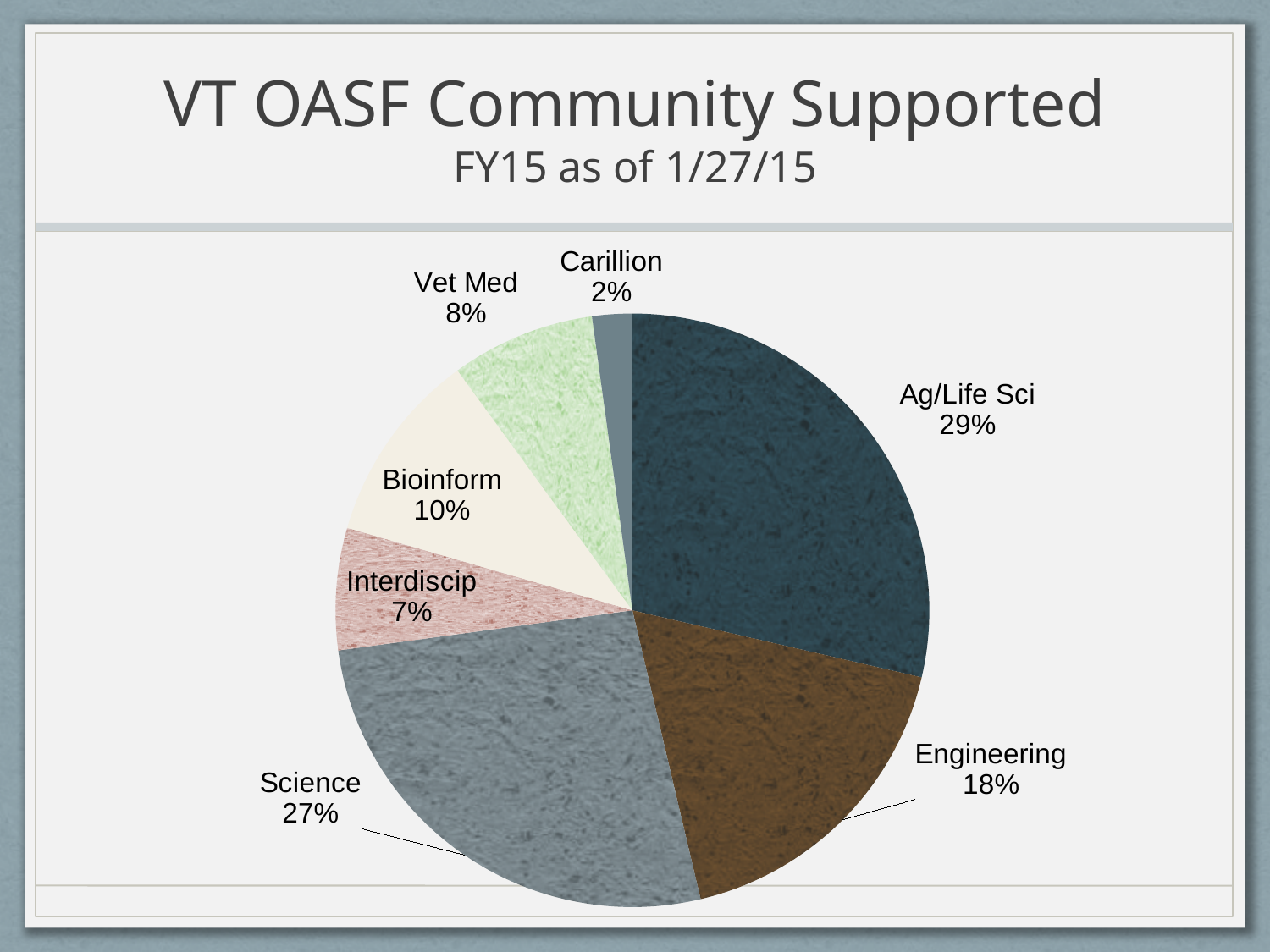
Which category has the smallest slice of the pie? Carillion What is the difference in percentage points between Science and Engineering? 9 How many categories are shown in the pie chart? 7 What percentage is shown for Bioinform? 10% What is the combined percentage of Ag/Life Sci and Science? 56% What percentage is shown for Engineering? 18% Which is larger, Vet Med or Interdiscip? Vet Med What percentage is shown for Carillion? 2% Which category has the largest slice of the pie? Ag/Life Sci What kind of chart is shown on the slide? Pie chart What share of the pie does Ag/Life Sci hold? 29% What is the title of the chart on the slide? VT OASF Community Supported FY15 as of 1/27/15